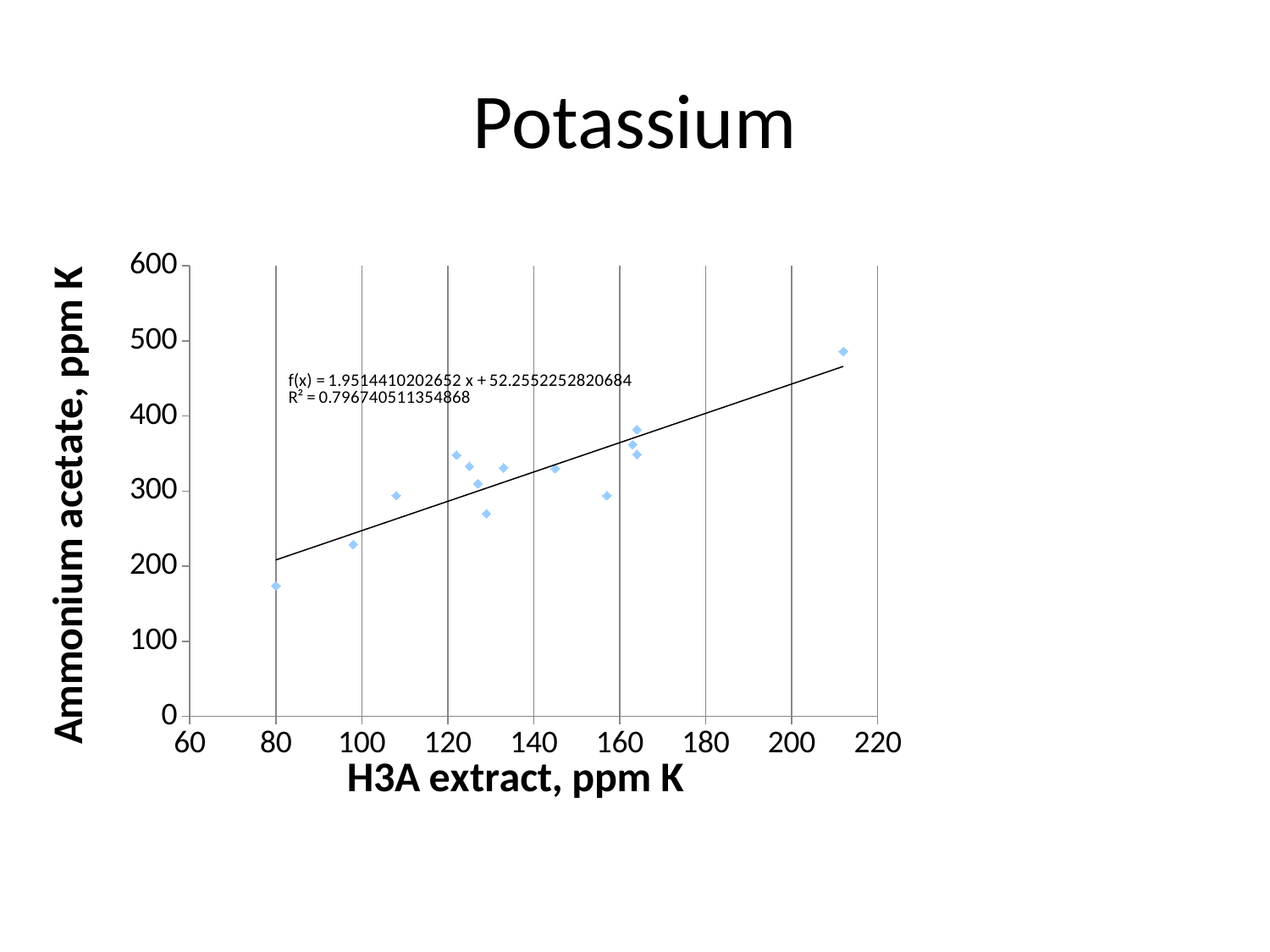
What is the intercept of the fitted line equation printed on the chart? 52.2552252820684 Is the ammonium acetate value of the leftmost point (at 80 ppm K H3A extract) greater or less than 200? less Is the ammonium acetate value of the point at about 98 ppm K H3A extract greater or less than 300? less What is the label of the x axis? H3A extract, ppm K Is the ammonium acetate value of the highest point (at about 212 ppm K H3A extract) greater or less than 400? greater What is the slope of the fitted line equation printed on the chart? 1.9514410202652 Which point has the higher ammonium acetate value: the one at about 212 ppm K H3A extract or the one at 80 ppm K H3A extract? the one at about 212 ppm K Do the ammonium acetate values generally rise or fall as the H3A extract value increases along the x axis? rise What is the title of the chart? Potassium What kind of chart is shown on the slide? scatter chart What is the maximum value shown on the y axis? 600 What R² value is printed on the chart? 0.796740511354868